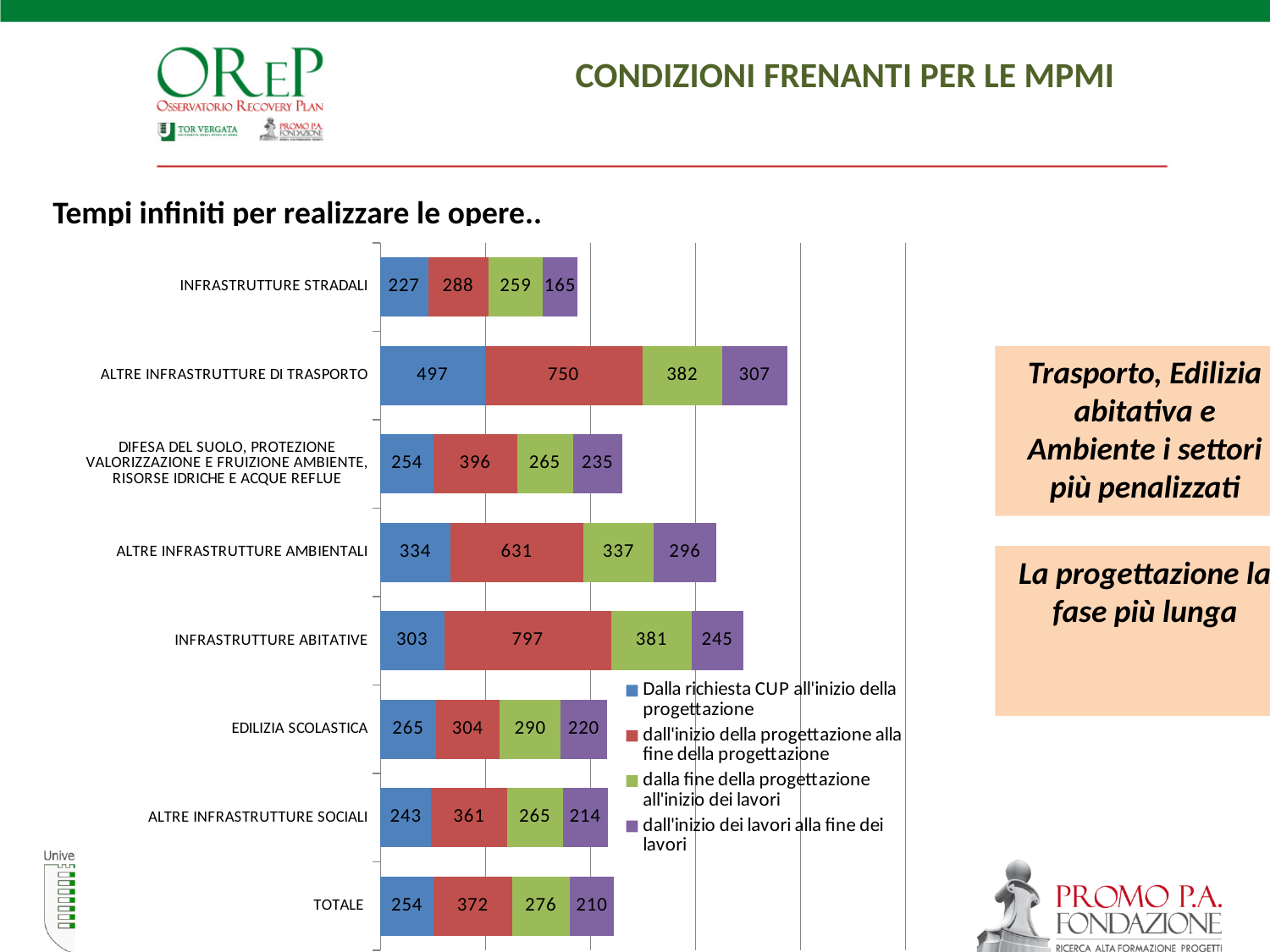
Which is larger: the 'dalla fine della progettazione all'inizio dei lavori' value for ALTRE INFRASTRUTTURE DI TRASPORTO or for EDILIZIA SCOLASTICA? ALTRE INFRASTRUTTURE DI TRASPORTO How many series does the legend list? 4 Which category has the highest value for 'dall'inizio della progettazione alla fine della progettazione'? INFRASTRUTTURE ABITATIVE What is the value of 'Dalla richiesta CUP all'inizio della progettazione' for ALTRE INFRASTRUTTURE DI TRASPORTO? 497 Which category has the lowest value for 'Dalla richiesta CUP all'inizio della progettazione'? INFRASTRUTTURE STRADALI What is the value of 'dall'inizio dei lavori alla fine dei lavori' for TOTALE? 210 What type of chart is shown on the slide? Stacked bar chart Which colour represents 'dall'inizio dei lavori alla fine dei lavori' in the chart? Purple What is the difference between the 'dall'inizio della progettazione alla fine della progettazione' values for ALTRE INFRASTRUTTURE DI TRASPORTO and INFRASTRUTTURE STRADALI? 462 What is the total of the stacked bar for INFRASTRUTTURE STRADALI? 939 How many categories are plotted on the chart? 8 What is the value of 'dall'inizio della progettazione alla fine della progettazione' for INFRASTRUTTURE ABITATIVE? 797